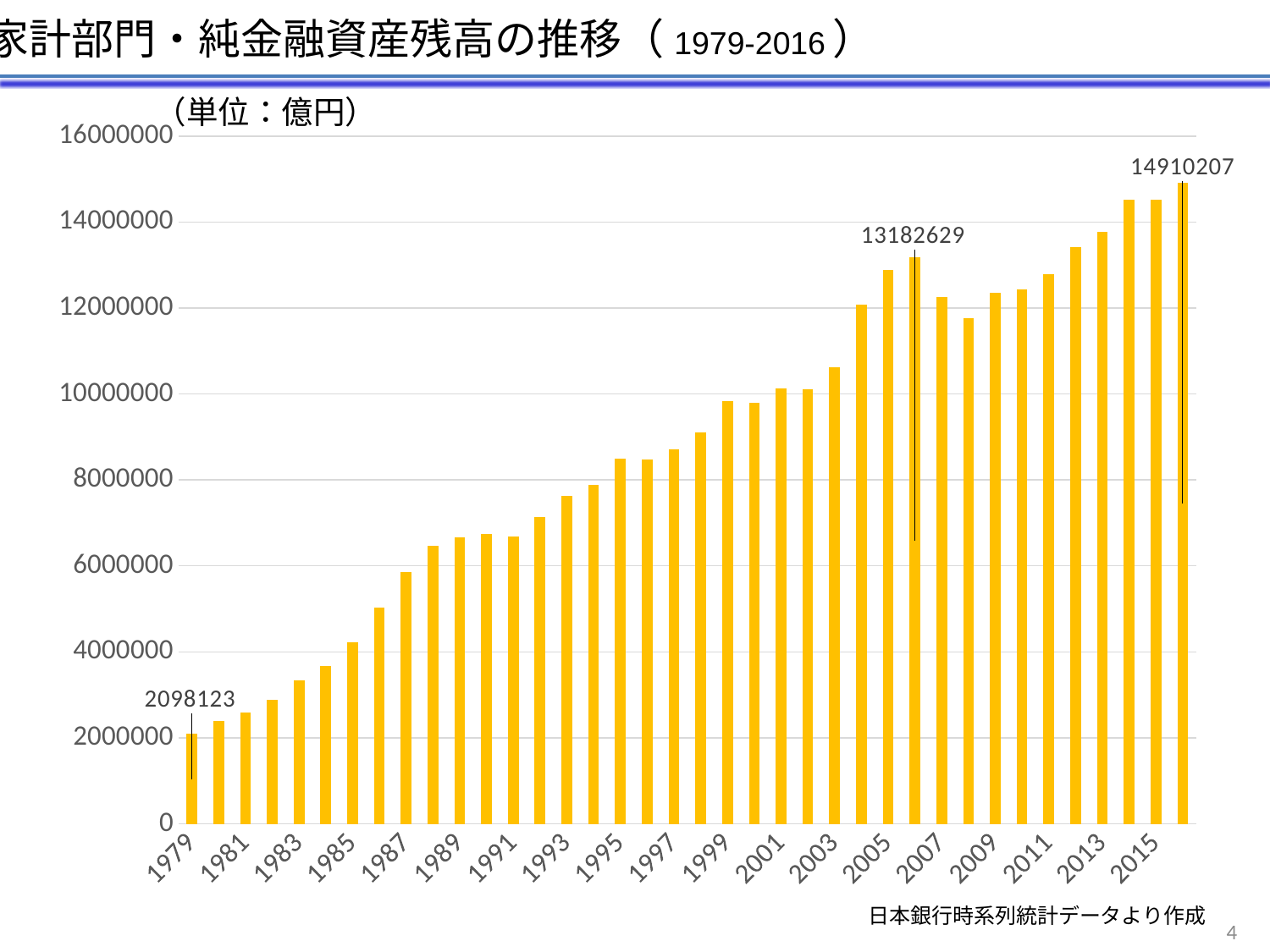
Is the value for 1995 greater or less than 8000000? greater What is the difference between the values for 2016 and 2006? 1727578 Which is larger, the value for 2006 or the value for 2016? 2016 What is the value for 2006? 13182629 Which year has the highest value? 2016 What kind of chart is shown on the slide? bar chart What is the difference between the values for 2016 and 1979? 12812084 Which year has the lowest value? 1979 What unit is stated for the values in the chart? 億円 What is the value for 1979? 2098123 How many bars are plotted in the chart? 38 What is the value for 2016? 14910207